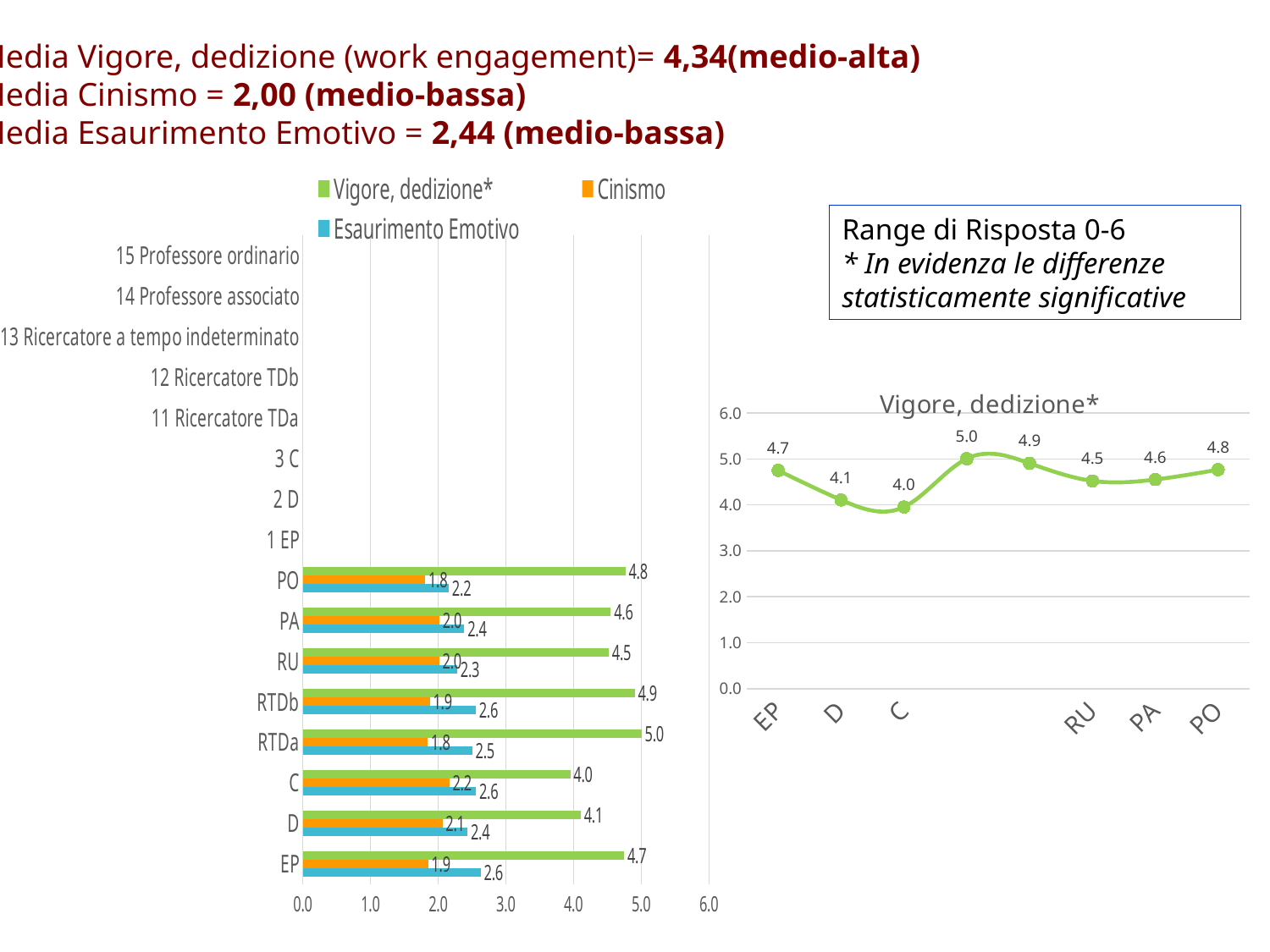
In the line chart titled 'Vigore, dedizione*', is the value for C greater or less than 5.0? less In the bar chart on the left, what is the Cinismo value for C? 2.2 In the bar chart on the left, which category has the lowest Vigore, dedizione* value? C In the line chart titled 'Vigore, dedizione*', what is the value for D? 4.1 In the bar chart on the left, what is the Esaurimento Emotivo value for EP? 2.6 In the line chart titled 'Vigore, dedizione*', what is the highest value shown? 5.0 What kind of chart is the chart on the left? Bar chart In the line chart titled 'Vigore, dedizione*', how many data points are plotted? 8 In the bar chart on the left, which is larger: the Esaurimento Emotivo value for PO or for RTDb? RTDb How many series does the legend of the bar chart on the left list? 3 In the bar chart on the left, what is the Vigore, dedizione* value for RTDa? 5.0 In the bar chart on the left, what is the difference between the Vigore, dedizione* values for RTDa and C? 1.0